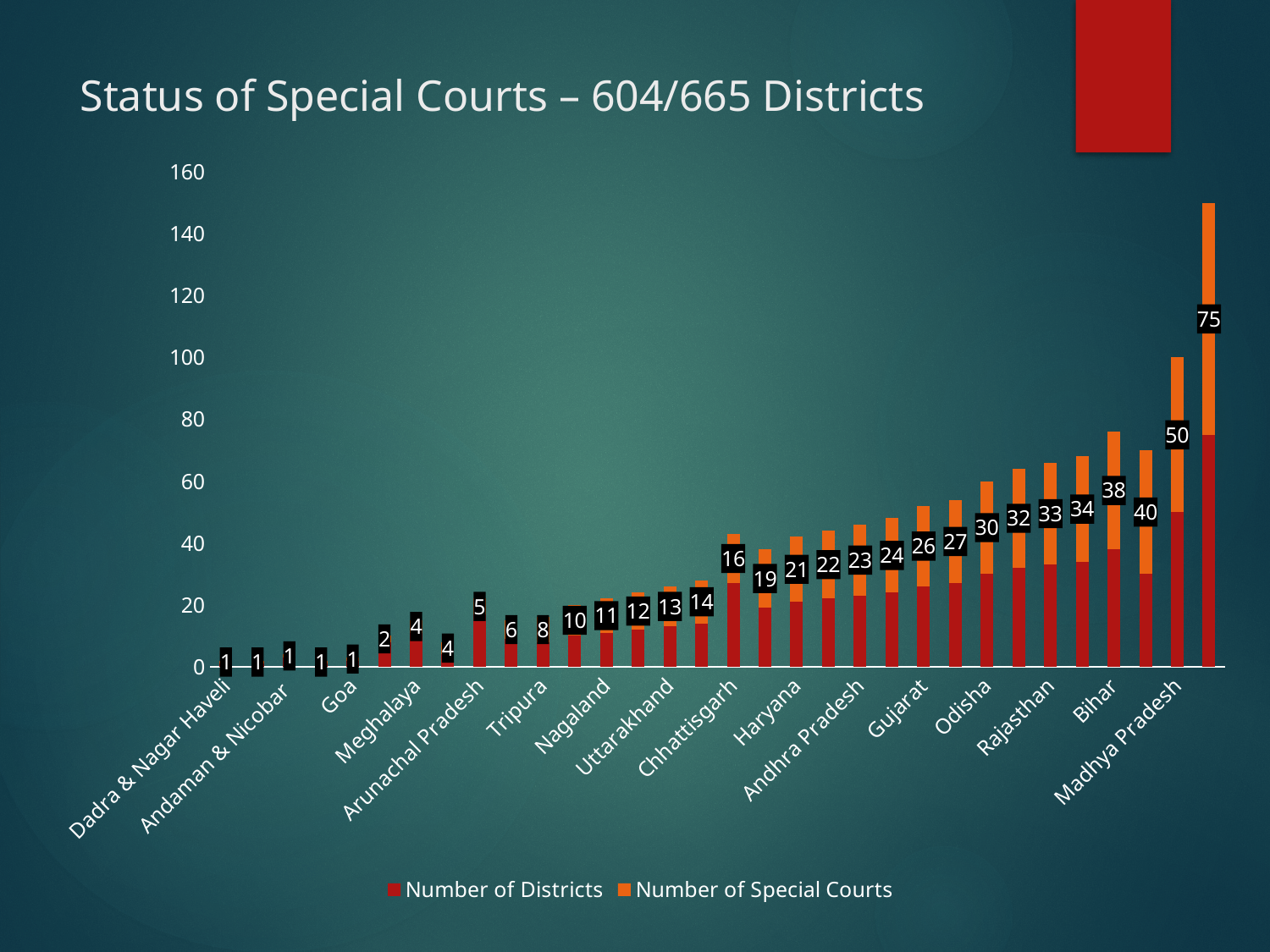
What is the labelled value on the bar for Bihar? 38 Which has the larger labelled value, Odisha or Gujarat? Odisha What type of chart is shown on the slide? Stacked bar chart What is the labelled value on the bar for Chhattisgarh? 16 How many series does the legend list? 2 What is the labelled value on the bar for Madhya Pradesh? 50 What is the difference between the labelled values for Bihar and Rajasthan? 5 What are the two series named in the legend? Number of Districts and Number of Special Courts What is the labelled value on the bar for Odisha? 30 What is the title of the chart? Status of Special Courts – 604/665 Districts Do the bar heights generally rise or fall from left to right along the x axis? Rise Is the total height of the stacked bar for Madhya Pradesh greater or less than 80? greater